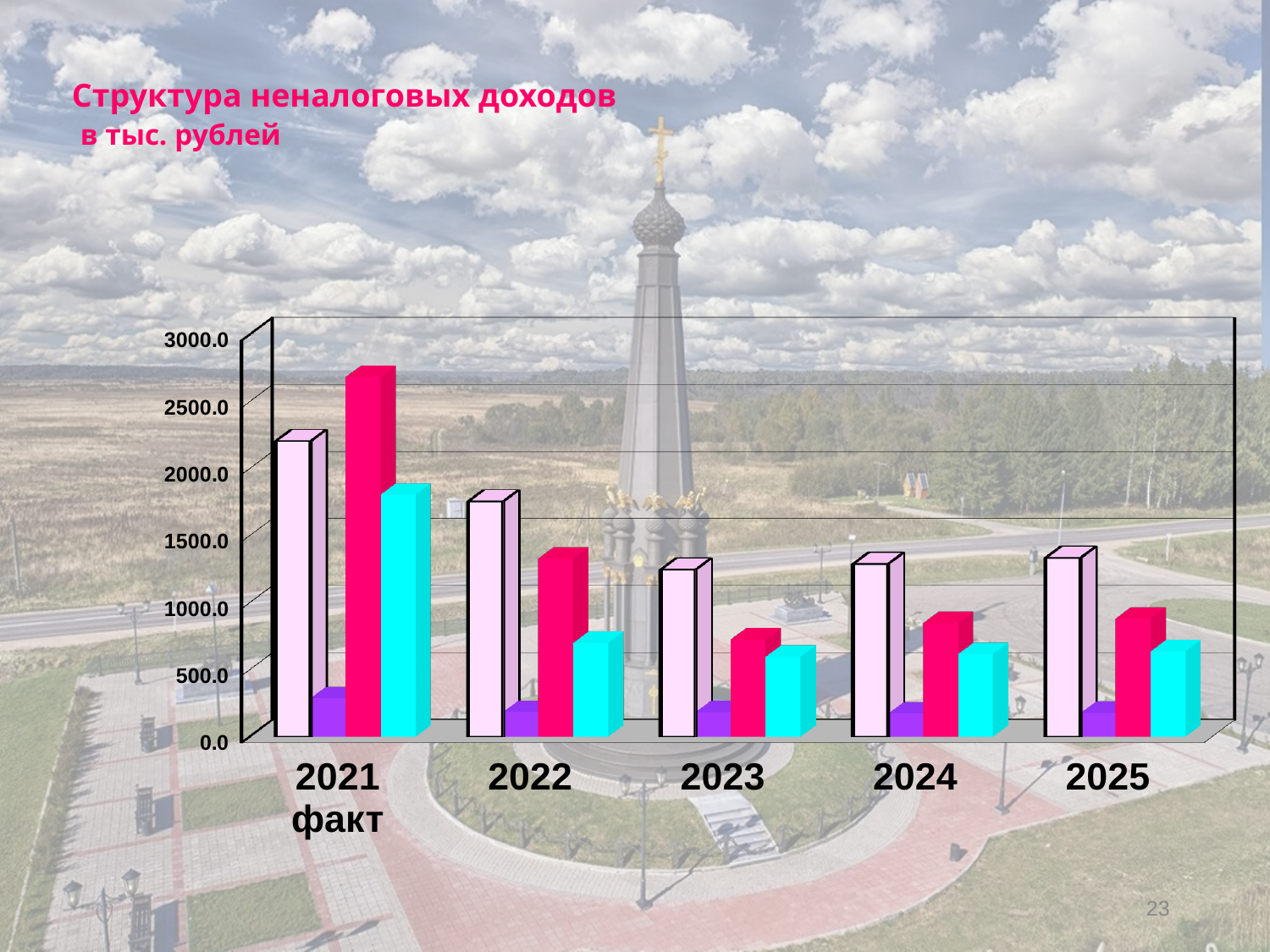
What is the title of the chart? Структура неналоговых доходов в тыс. рублей What kind of chart is shown on the slide? bar chart In which year is the magenta bar the tallest? 2021 Which year on the x axis is labelled with the word "факт"? 2021 In 2022, which bar is taller: the light pink bar or the magenta bar? the light pink bar Do the light pink bars rise or fall from 2021 to 2023? fall Is the value of the purple bar for 2021 greater or less than 500? less Is the value of the magenta bar for 2021 greater or less than 2500? greater How many years (categories) are shown on the x axis? 5 How many bars are plotted for each year? 4 Is the value of the cyan bar for 2022 greater or less than 1000? less